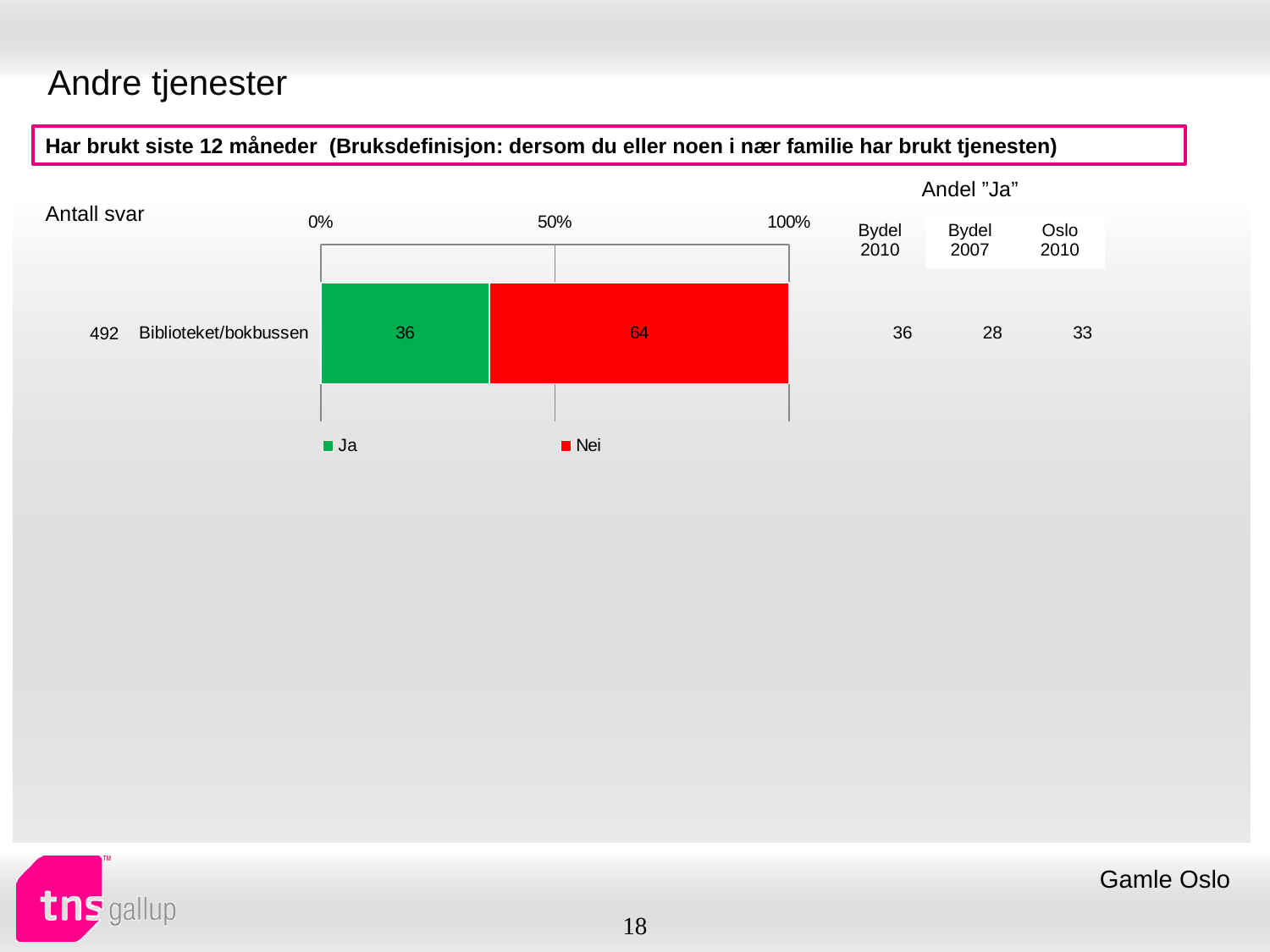
Is the "Nei" value for Biblioteket/bokbussen greater or less than 50%? greater What kind of chart is shown on the slide? Stacked bar chart How many series does the legend list? 2 How many categories are plotted in the chart? 1 What is the total of the stacked bar for Biblioteket/bokbussen? 100 Is the "Ja" value for Biblioteket/bokbussen greater or less than 50%? less What is the number of responses (Antall svar) shown for Biblioteket/bokbussen? 492 Which colour represents "Nei" in the chart? Red What is the difference between the "Nei" and "Ja" values for Biblioteket/bokbussen? 28 What is the value for "Ja" for Biblioteket/bokbussen? 36 Which is larger for Biblioteket/bokbussen, "Ja" or "Nei"? Nei What is the value for "Nei" for Biblioteket/bokbussen? 64